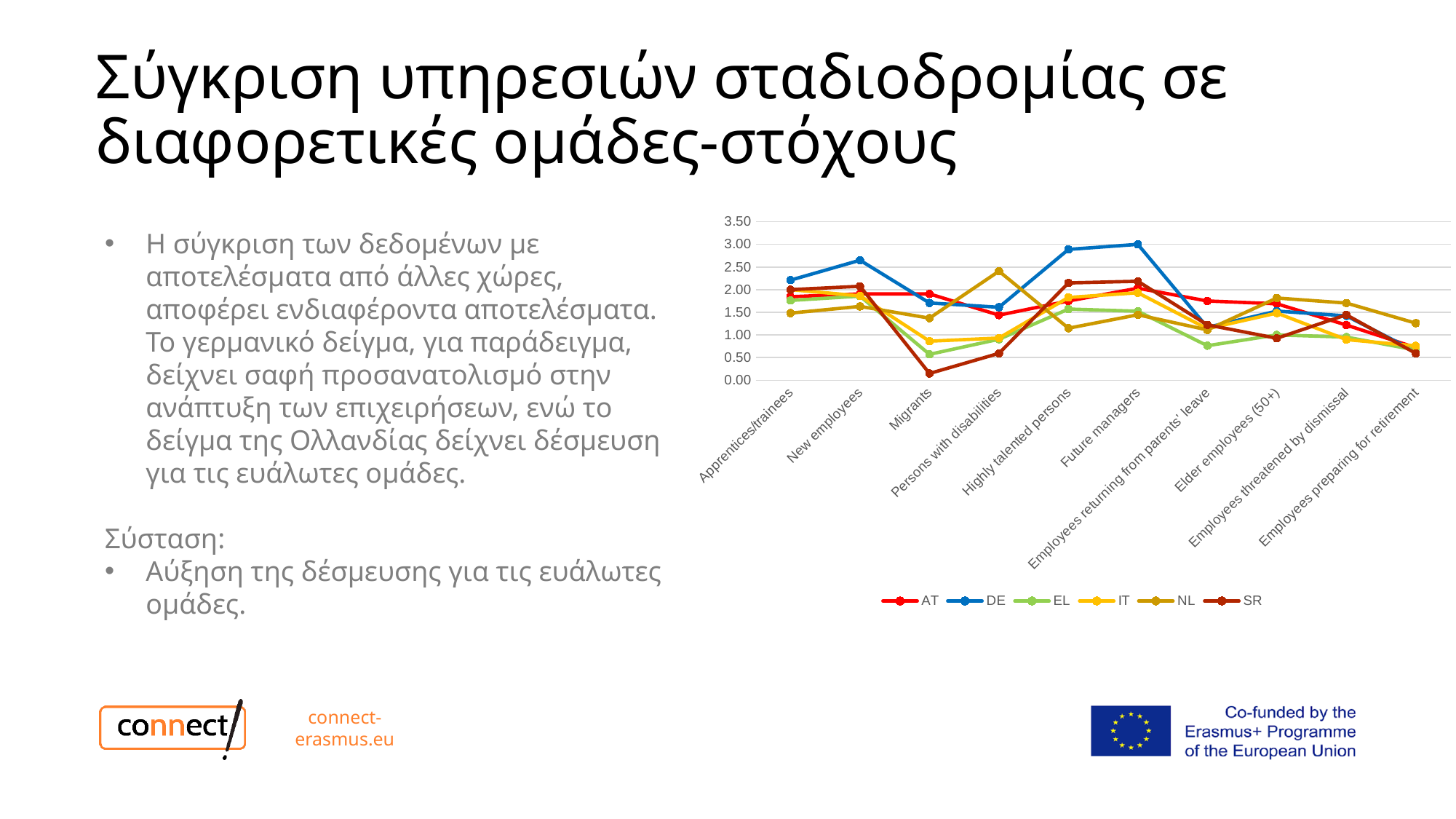
Is the DE value for Highly talented persons greater or less than 2.50? greater Is the EL value for Migrants greater or less than 1.00? less Which series has the lowest value for Migrants? SR Is the NL value for Persons with disabilities greater or less than 2.00? greater Which series has the highest value for Future managers? DE How many series does the chart legend list? 6 What kind of chart is shown on the slide? line chart For Persons with disabilities, which series has the larger value, NL or DE? NL What colour is the DE line in the legend? blue Does the NL line rise or fall from Elder employees (50+) to Employees preparing for retirement? fall How many target-group categories are plotted along the x axis? 10